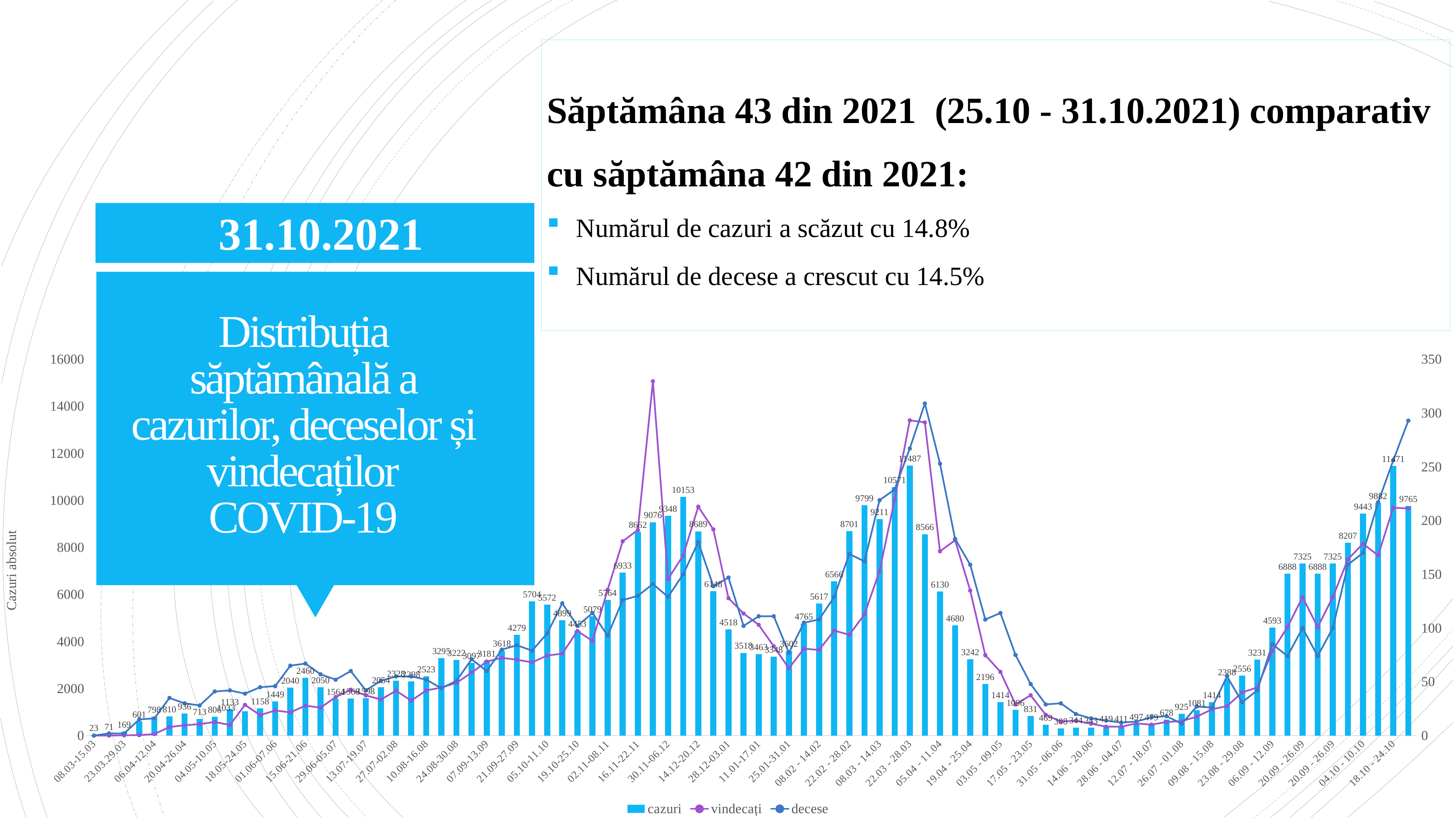
What is the difference between the tallest bar (11487) and the bar immediately before it (10571)? 916 What is the cazuri value of the last bar on the right of the chart? 9765 Is the peak of the decese line greater or less than 300 on the right axis? greater What is the title of the left vertical axis of the chart? Cazuri absolut What is the cazuri value for the first week, 08.03-15.03? 23 What are the three series named in the chart legend? cazuri, vindecați, decese Which is larger, the bar labeled 11471 or the final bar labeled 9765? 11471 What is the lowest value labeled on the cazuri bars? 23 What kind of chart is shown on the slide? A combined bar and line chart How many series does the chart legend list? 3 What is the difference between the bar labeled 11471 and the final bar labeled 9765? 1706 What is the highest value labeled on the cazuri bars? 11487